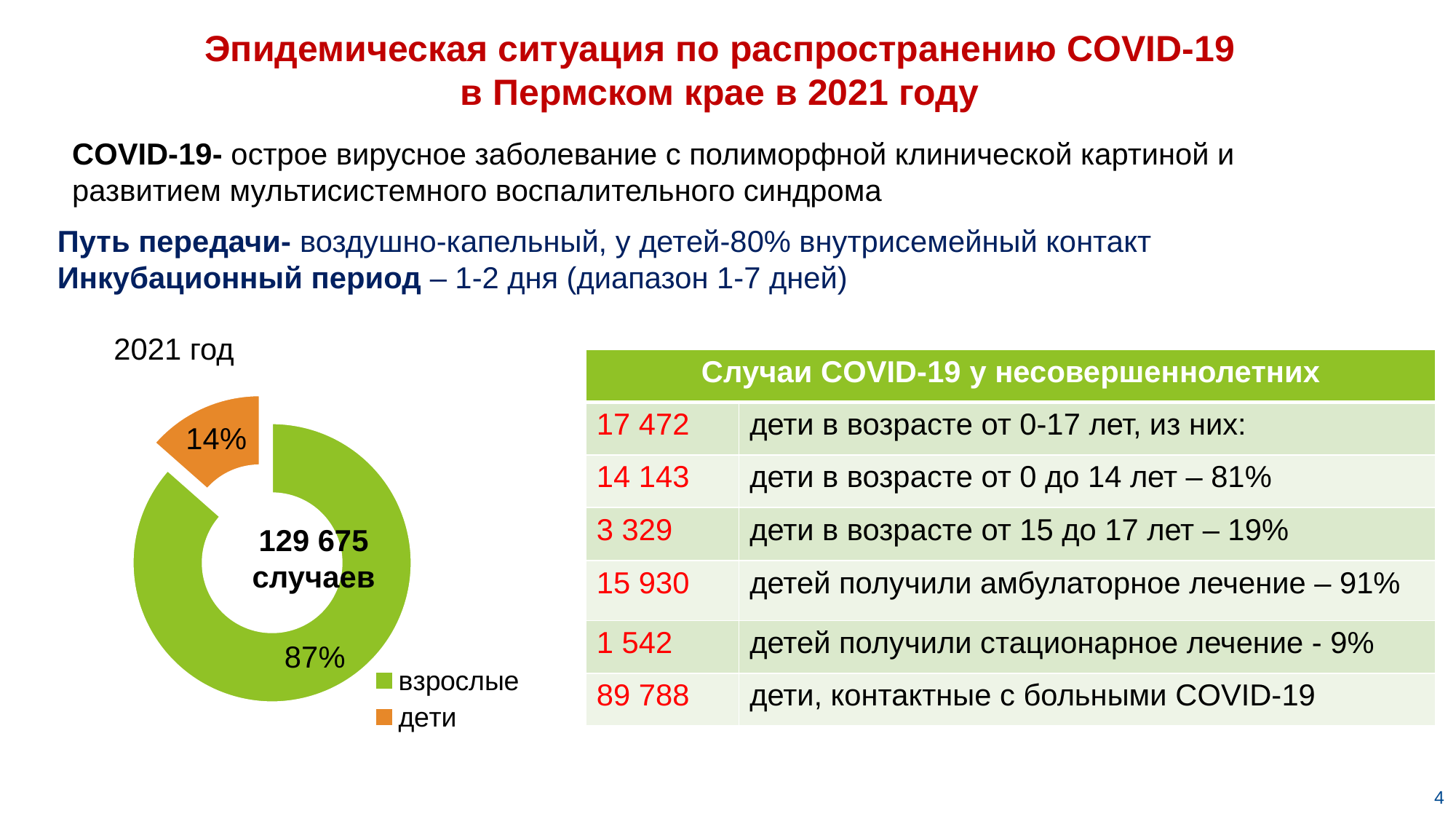
Which slice is larger in the doughnut chart, взрослые or дети? взрослые What total number of cases is printed in the centre of the doughnut chart? 129 675 случаев Which category has the largest slice in the doughnut chart? взрослые How many slices does the doughnut chart have? 2 What kind of chart is shown on the slide? Doughnut (pie) chart What is the title shown above the doughnut chart? 2021 год What colour is the дети slice in the doughnut chart? Orange Which category has the smallest slice in the doughnut chart? дети What share of the doughnut chart is labelled for взрослые? 87% What share of the doughnut chart is labelled for дети? 14% How many categories does the legend of the doughnut chart list? 2